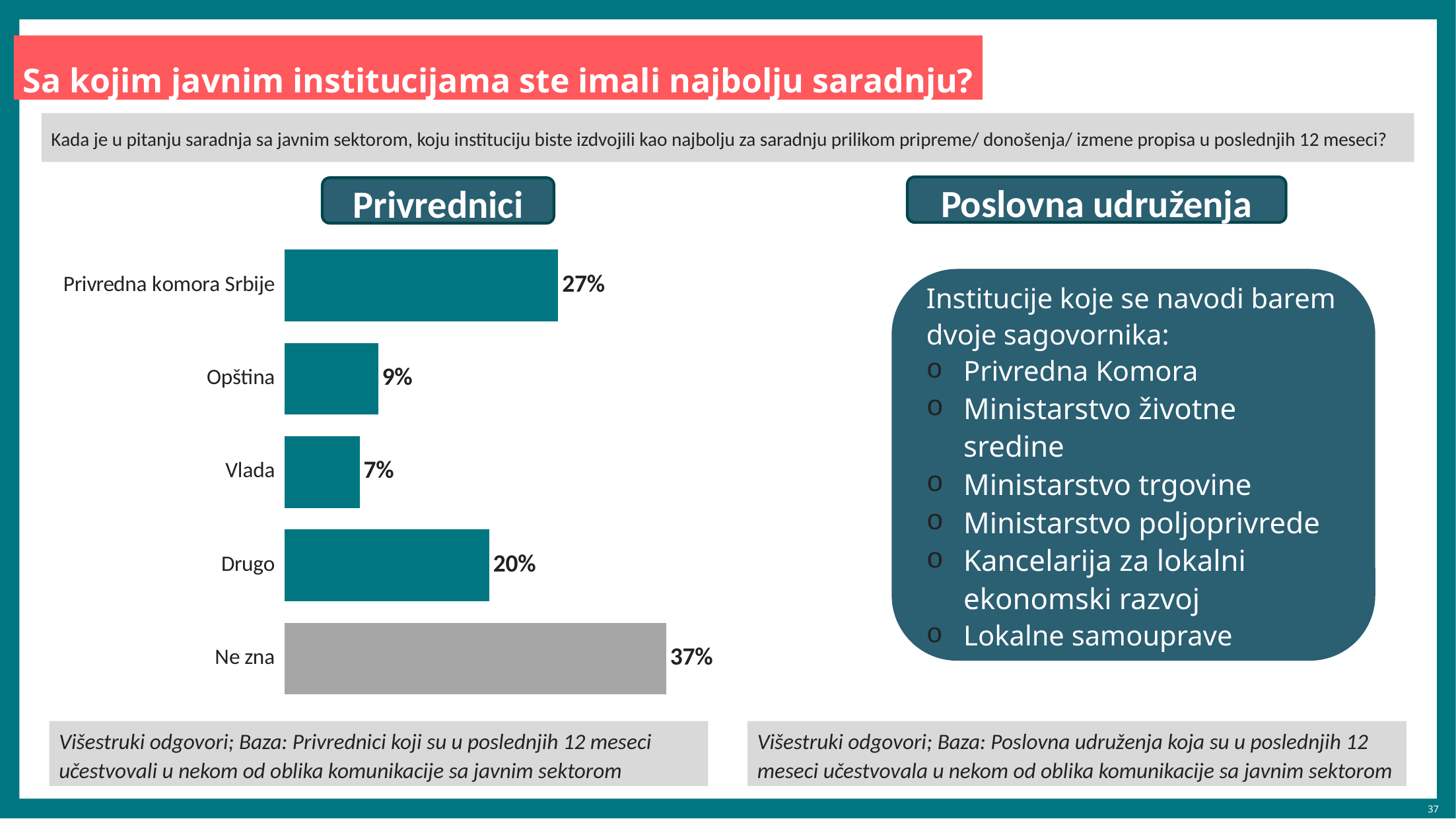
What is the value for Vlada in the Privrednici chart? 7% Which is larger in the Privrednici chart, Drugo or Opština? Drugo What is the value for Privredna komora Srbije in the Privrednici chart? 27% What is the difference between the values for Ne zna and Privredna komora Srbije in the Privrednici chart? 10% Which category has the lowest value in the Privrednici chart? Vlada Which category has the highest value in the Privrednici chart? Ne zna How many categories are shown in the Privrednici chart? 5 What kind of chart is the Privrednici chart? Bar chart Which bar in the Privrednici chart is coloured grey rather than teal? Ne zna What is the value for Ne zna in the Privrednici chart? 37% What is the value for Opština in the Privrednici chart? 9% What is the value for Drugo in the Privrednici chart? 20%